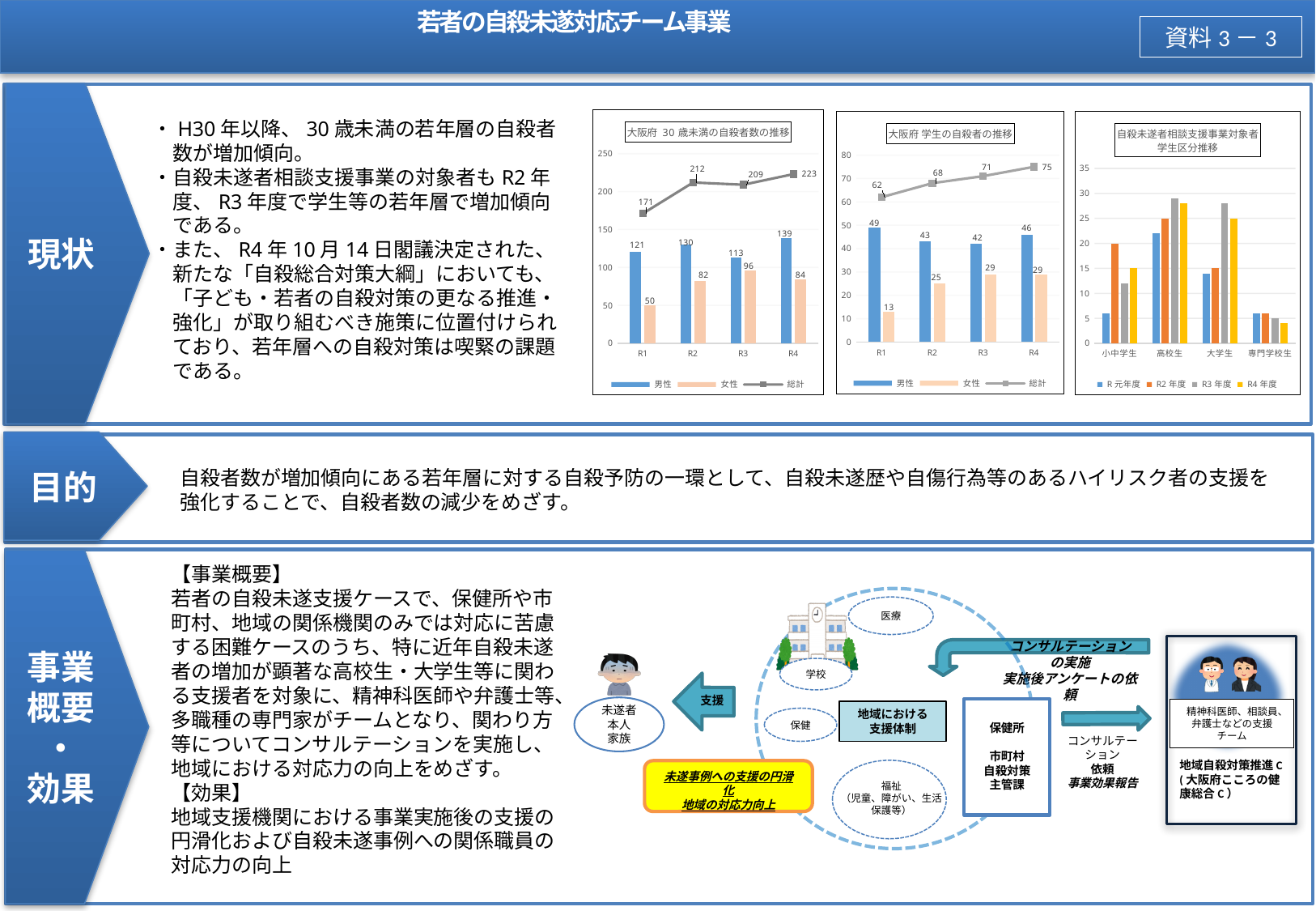
In the chart titled 大阪府 30歳未満の自殺者数の推移, what is the 総計 value for R4? 223 In the chart titled 自殺未遂者相談支援事業対象者 学生区分推移, is the R3年度 value for 高校生 greater or less than 25? greater In the chart titled 大阪府 30歳未満の自殺者数の推移, what is the difference between the 男性 and 女性 values for R1? 71 In the chart titled 大阪府 学生の自殺者の推移, which year has the lowest 女性 value? R1 In the chart titled 大阪府 30歳未満の自殺者数の推移, what is the 女性 value for R3? 96 In the chart titled 大阪府 学生の自殺者の推移, how many series does the legend list? 3 In the chart titled 大阪府 学生の自殺者の推移, does the 総計 line rise or fall from R1 to R4? rise In the chart titled 大阪府 30歳未満の自殺者数の推移, which year has the highest 男性 value? R4 In the chart titled 大阪府 学生の自殺者の推移, what is the 総計 value for R3? 71 In the chart titled 自殺未遂者相談支援事業対象者 学生区分推移, how many student categories are shown on the x axis? 4 In the chart titled 自殺未遂者相談支援事業対象者 学生区分推移, which category has the lowest R4年度 value? 専門学校生 What kind of chart is the chart titled 自殺未遂者相談支援事業対象者 学生区分推移? bar chart